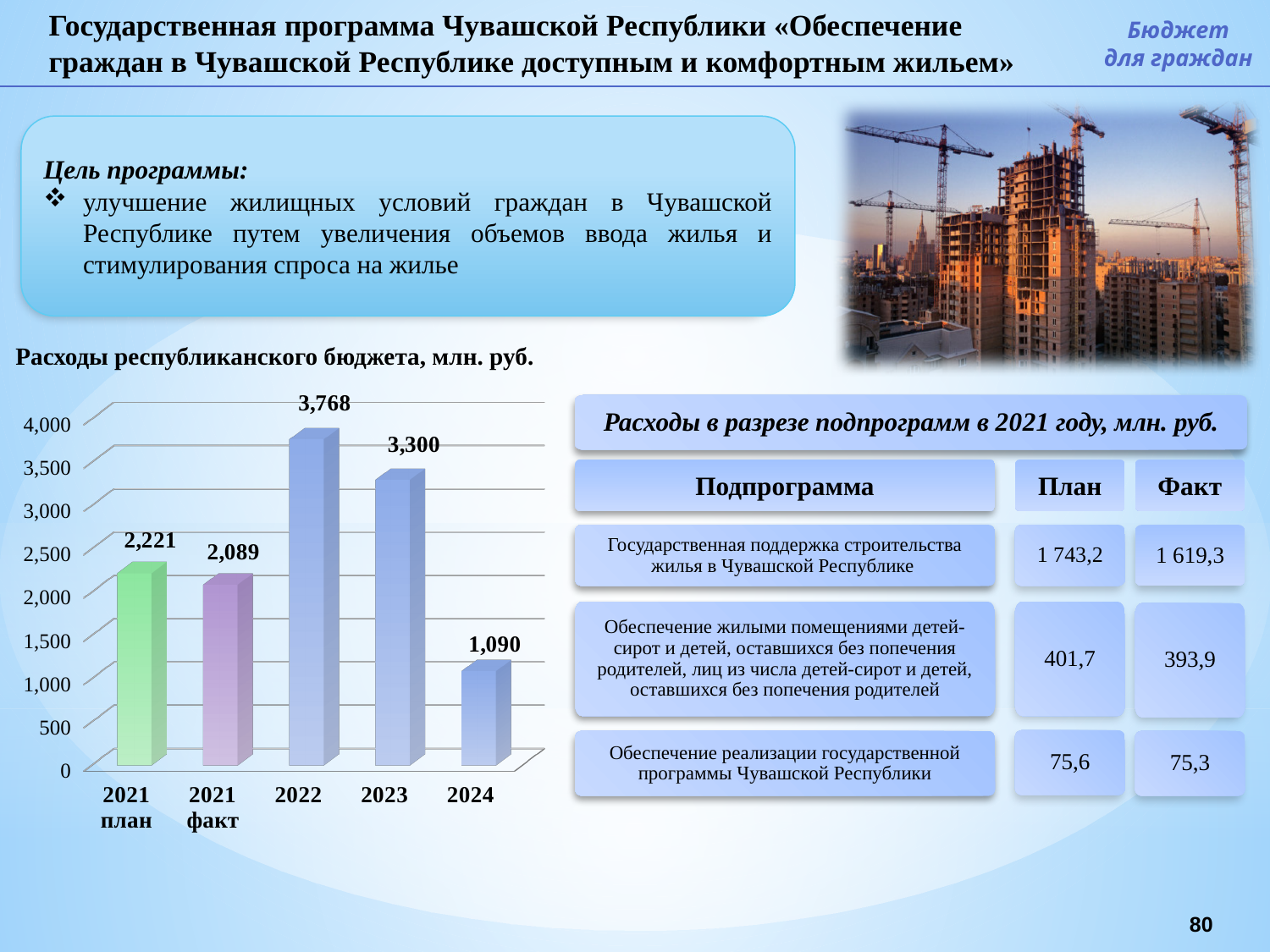
What kind of chart is shown on the slide? bar chart What is the value for 2024 in the chart? 1,090 What is the value for 2022 in the chart? 3,768 How many bars are shown in the chart? 5 Which category has the lowest value in the chart? 2024 What is the value for 2021 факт in the chart? 2,089 What is the title of the chart on the slide? Расходы республиканского бюджета, млн. руб. What is the difference between 2021 план and 2021 факт? 132 Which is larger, the value for 2023 or the value for 2024? 2023 Which category has the highest value in the chart? 2022 What is the value for 2021 план in the chart 'Расходы республиканского бюджета, млн. руб.'? 2,221 What is the difference between the values for 2022 and 2023? 468